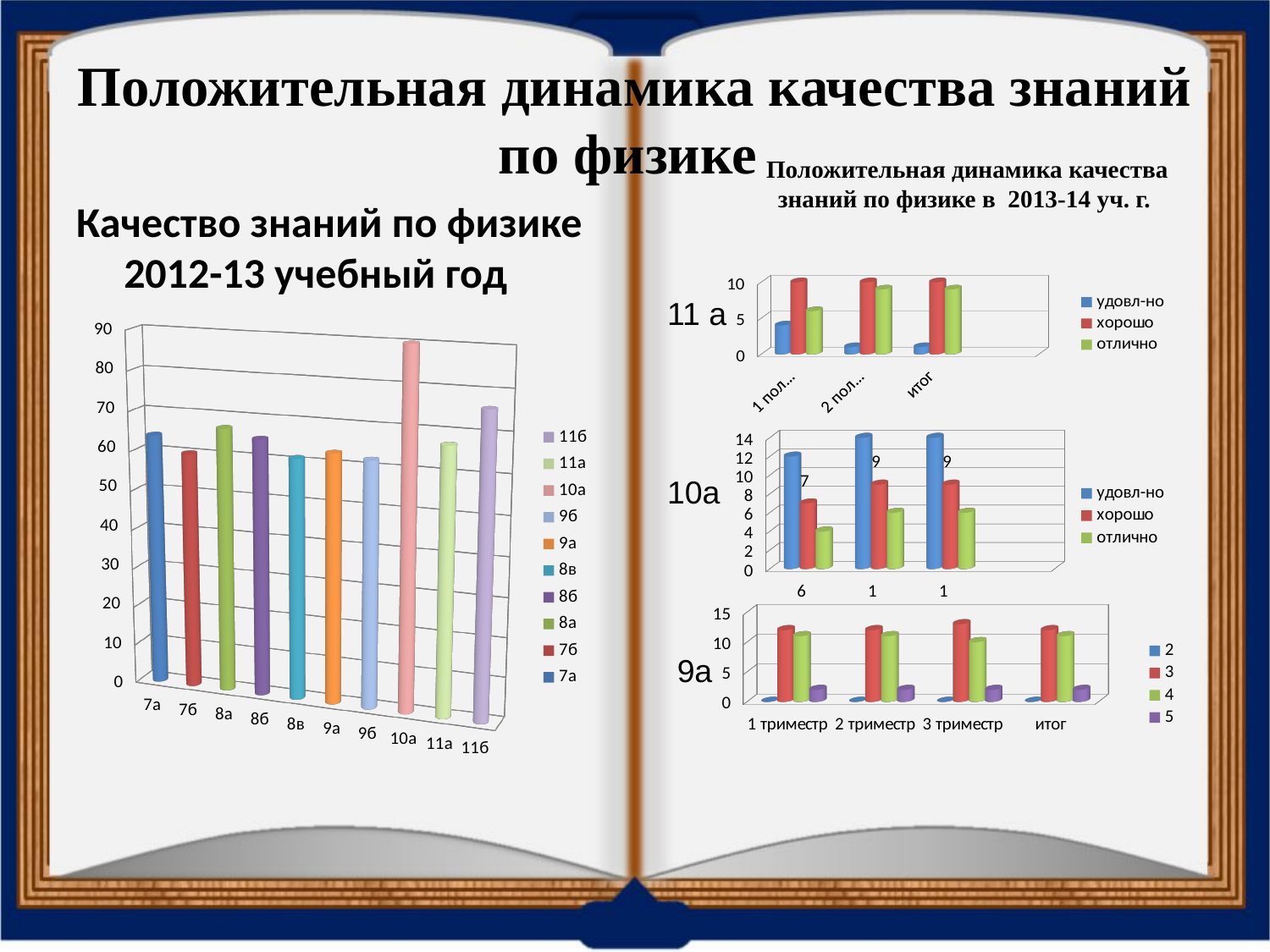
On the chart 'Качество знаний по физике 2012-13 учебный год', which class has the highest value? 10а What kind of chart is 'Качество знаний по физике 2012-13 учебный год'? bar chart On the chart 'Качество знаний по физике 2012-13 учебный год', which is larger, the value for 8а or the value for 8в? 8а On the chart labelled 9а, which series has the highest value in '3 триместр'? 3 On the chart 'Качество знаний по физике 2012-13 учебный год', how many classes are shown on the x axis? 10 On the chart labelled 9а, how many categories are shown on the x axis? 4 On the chart 'Качество знаний по физике 2012-13 учебный год', is the value for 7а greater or less than 60? greater On the chart labelled 11 а, how many series does the legend list? 3 On the chart labelled 11 а, which series has the highest value in the 'итог' category? хорошо On the chart 'Качество знаний по физике 2012-13 учебный год', is the value for 10а greater or less than 80? greater On the chart labelled 10а, what is the value of 'хорошо' in the first category? 7 On the chart labelled 10а, what is the difference between the 'хорошо' values in the second and first categories? 2